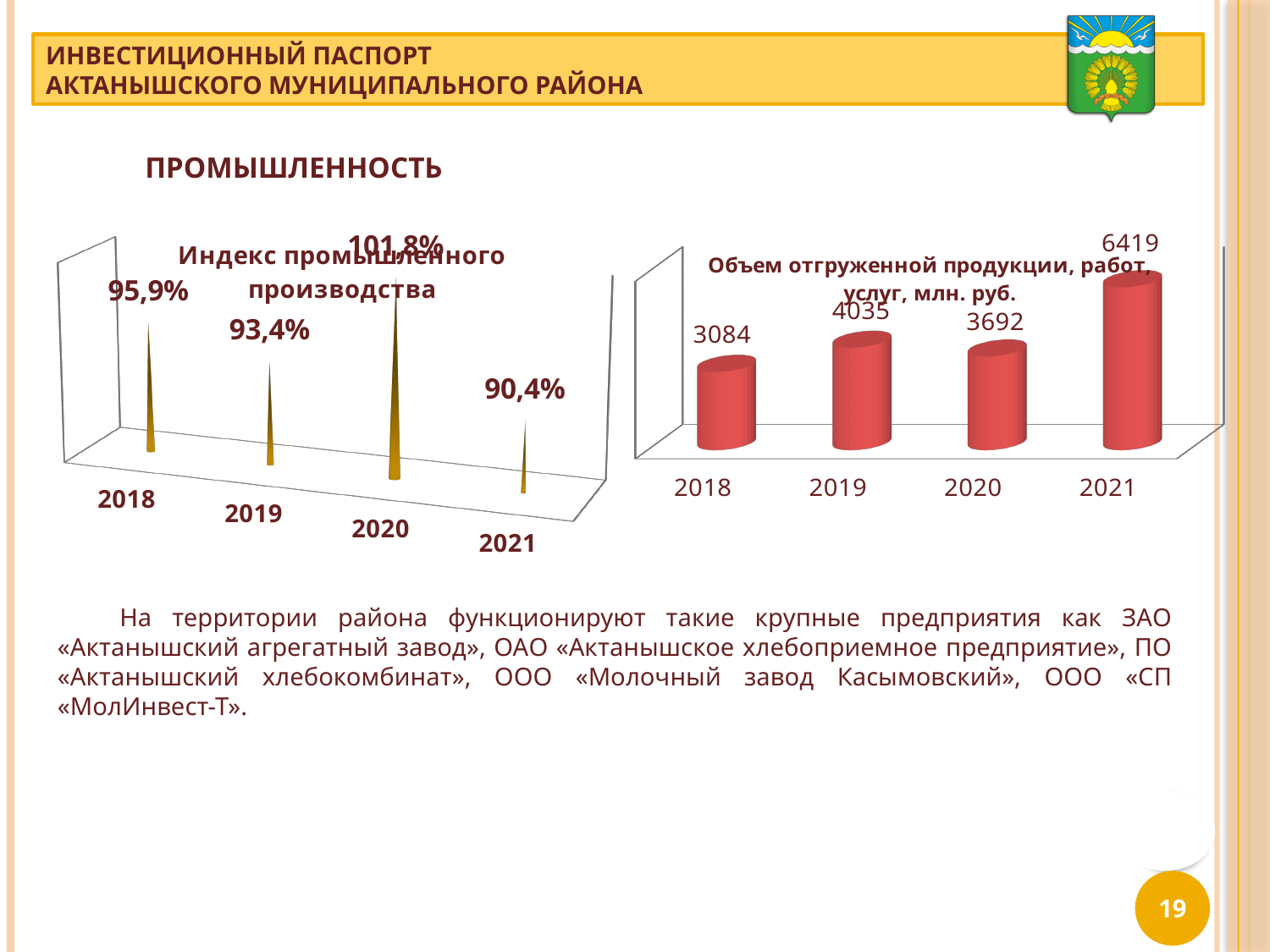
In the chart 'Объем отгруженной продукции, работ, услуг, млн. руб.', what is the difference between the values for 2021 and 2020? 2727 In the chart 'Объем отгруженной продукции, работ, услуг, млн. руб.', which year has the highest value? 2021 In the chart 'Объем отгруженной продукции, работ, услуг, млн. руб.', what is the value for 2019? 4035 In the chart 'Индекс промышленного производства', which year has the highest value? 2020 In the chart 'Объем отгруженной продукции, работ, услуг, млн. руб.', which is larger, the value for 2019 or 2020? 2019 In the chart 'Индекс промышленного производства', how many years are shown? 4 In the chart 'Индекс промышленного производства', which year has the lowest value? 2021 In the chart 'Объем отгруженной продукции, работ, услуг, млн. руб.', what is the value for 2021? 6419 In the chart 'Индекс промышленного производства', what is the value for 2020? 101,8% In the chart 'Объем отгруженной продукции, работ, услуг, млн. руб.', which year has the lowest value? 2018 In the chart 'Индекс промышленного производства', what is the value for 2018? 95,9% What kind of chart is the chart 'Объем отгруженной продукции, работ, услуг, млн. руб.'? Bar chart